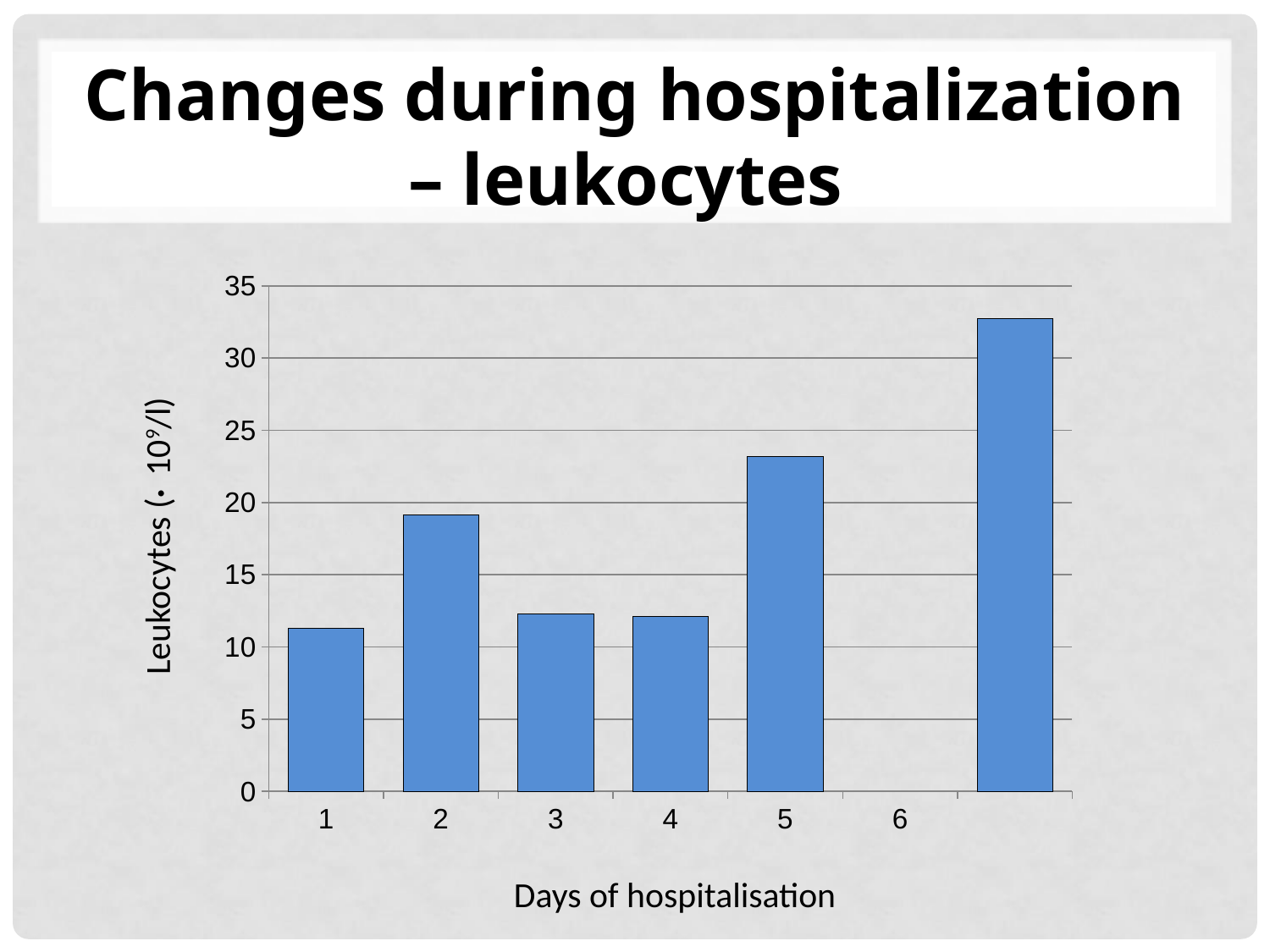
Is the leukocyte value on day 4 greater or less than 15? less Which has the higher leukocyte value, day 1 or day 2? day 2 Is the leukocyte value on day 1 greater or less than 10? greater Among days 1 to 5, which day has the highest leukocyte value? 5 Is the leukocyte value on day 5 greater or less than 20? greater How many bars are plotted in the chart? 6 What is the title of the x axis? Days of hospitalisation What kind of chart is shown on the slide? bar chart Does the leukocyte value rise or fall from day 4 to day 5? rise Which has the higher leukocyte value, day 2 or day 5? day 5